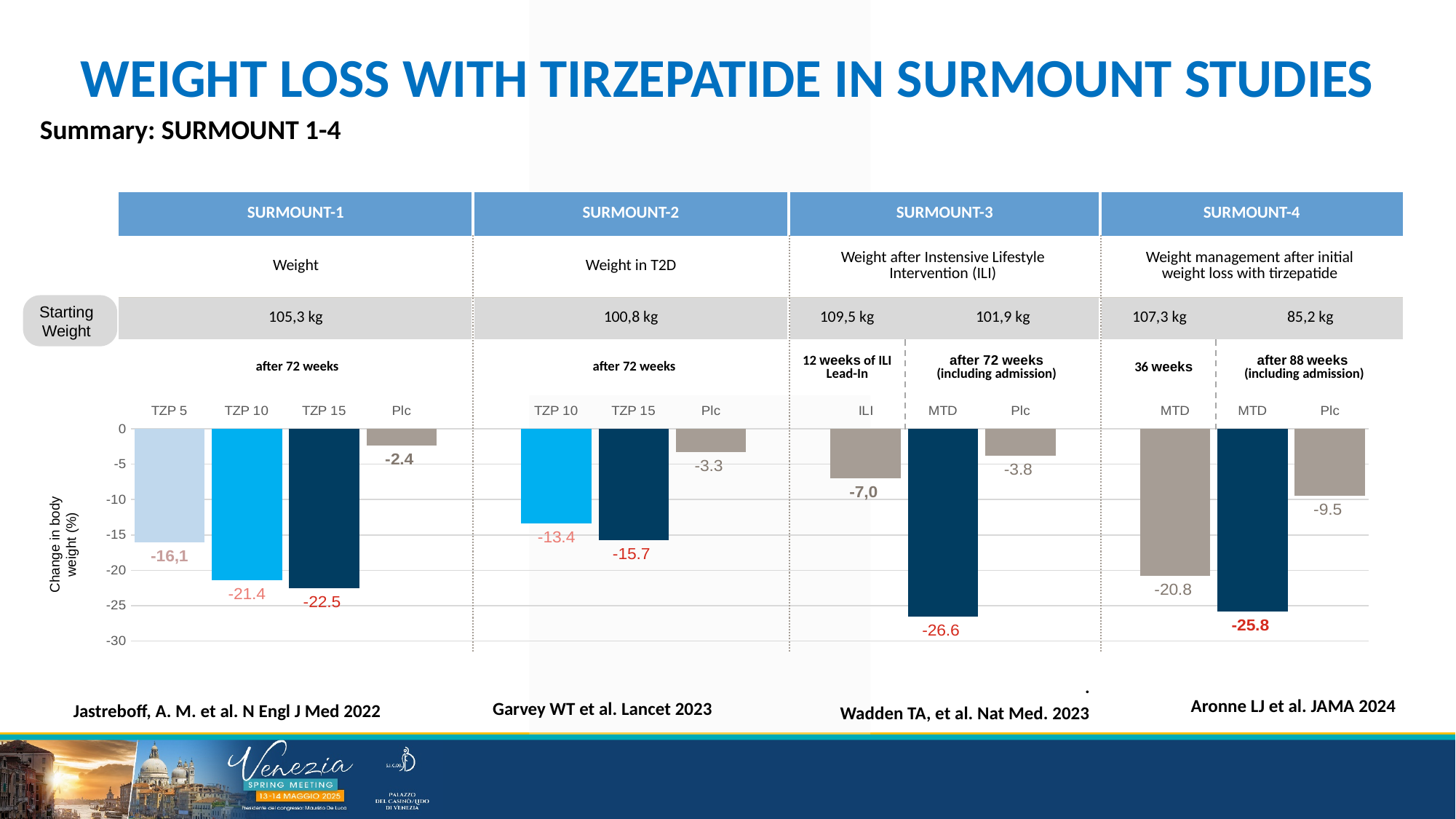
In the SURMOUNT-2 panel, what is the difference between the TZP 15 and TZP 10 values? 2.3 How many bars are shown in the SURMOUNT-1 panel? 4 Which shows a larger weight loss: TZP 15 in SURMOUNT-1 or TZP 15 in SURMOUNT-2? TZP 15 in SURMOUNT-1 In the SURMOUNT-2 panel, what is the change in body weight for Plc? -3.3 In the SURMOUNT-4 panel, what is the change in body weight for Plc after 88 weeks? -9.5 What type of chart is used to show the change in body weight? Bar chart In the SURMOUNT-1 panel, what is the difference between the TZP 15 and TZP 10 values? 1.1 In the SURMOUNT-1 panel, what is the change in body weight for TZP 15? -22.5 In the SURMOUNT-3 panel, what is the change in body weight for MTD after 72 weeks? -26.6 In the SURMOUNT-2 panel, which bar shows the smallest change in body weight? Plc In the SURMOUNT-1 panel, which bar shows the largest weight loss? TZP 15 What is the starting weight shown for SURMOUNT-2? 100,8 kg